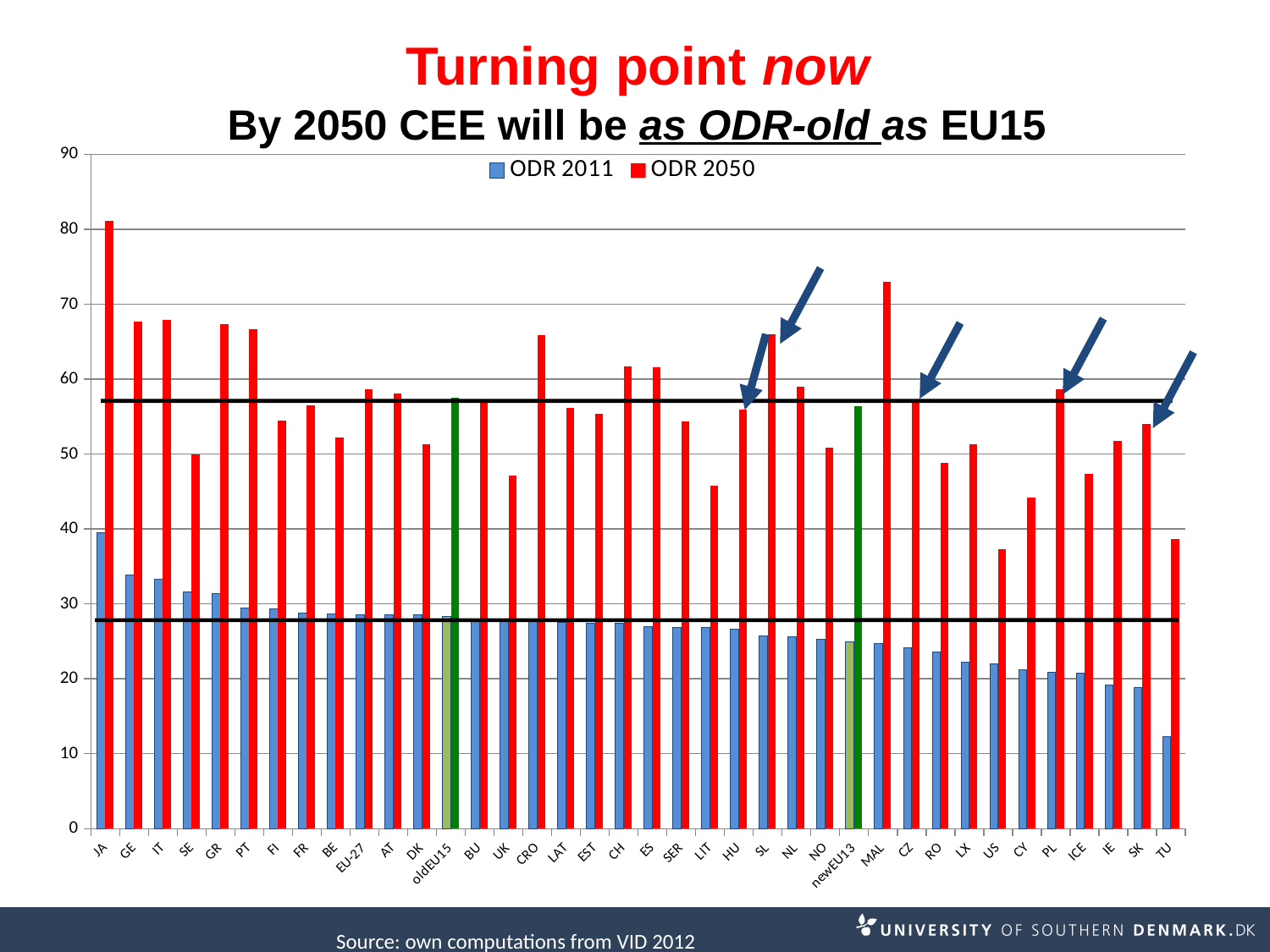
What kind of chart is shown on the slide? bar chart Is the ODR 2011 value for TU greater or less than 20? less Is the ODR 2050 value for MAL greater or less than 70? greater Which category has the highest ODR 2050 value? JA Which category has the lowest ODR 2011 value? TU Which is larger, the ODR 2050 value for JA or for GE? JA Is the ODR 2050 value for JA greater or less than 70? greater Do the ODR 2011 values generally rise or fall moving from left to right along the x axis? fall How many series does the legend list? 2 How many countries or groups are shown along the x axis? 38 What are the two series named in the legend? ODR 2011 and ODR 2050 Which category has the highest ODR 2011 value? JA